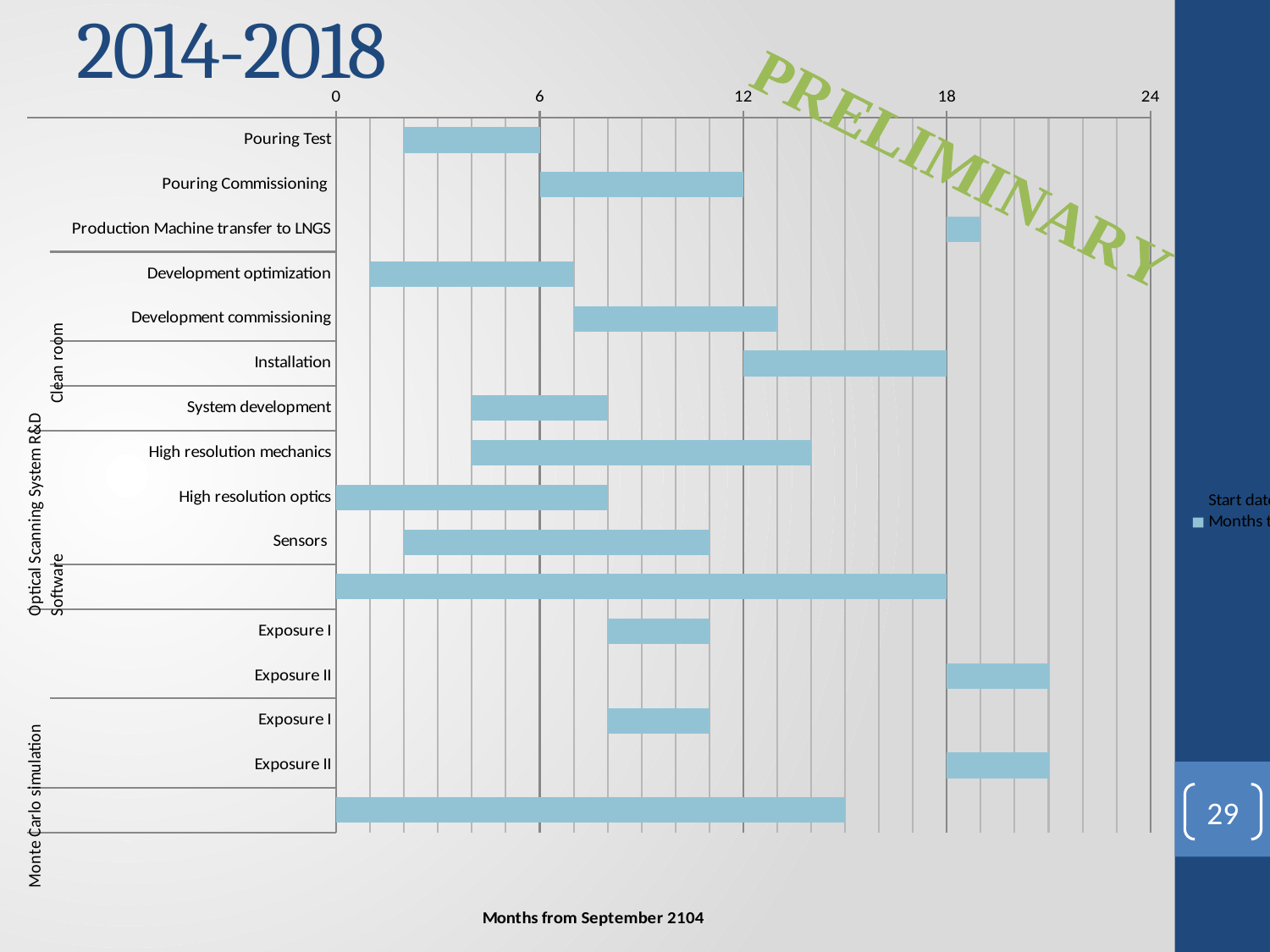
What is the title of the x axis? Months from September 2104 What kind of chart is shown on the slide? bar chart (Gantt chart) Which starts later, Pouring Test or Pouring Commissioning? Pouring Commissioning At which month does the Installation bar start? 12 At which month does the Pouring Commissioning bar end? 12 Is the end of the Sensors bar greater or less than 12? less Which bar is longer, Installation or Pouring Test? Installation At which month does the Installation bar end? 18 Is the end of the Development commissioning bar greater or less than 12? greater At which month does the Pouring Test bar end? 6 Is the end of the Exposure II bar greater or less than 24? less